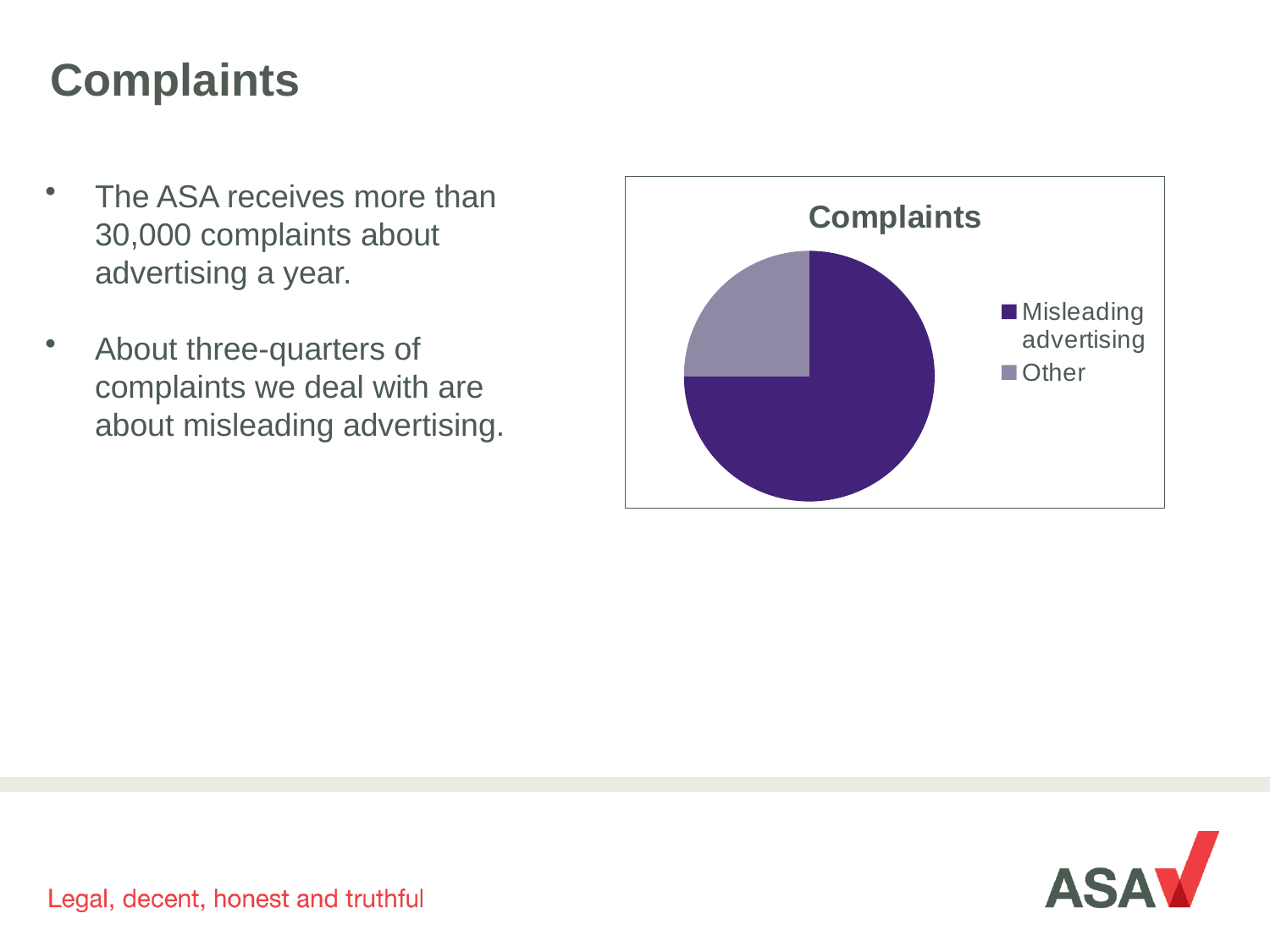
Which category is shown in the dark purple colour? Misleading advertising How many entries does the chart's legend list? 2 Which slice is larger, Misleading advertising or Other? Misleading advertising Which category has the largest slice of the pie? Misleading advertising Which category has the smallest slice of the pie? Other How many slices does the pie chart have? 2 What is the title of the chart? Complaints What kind of chart is shown on the slide? pie chart